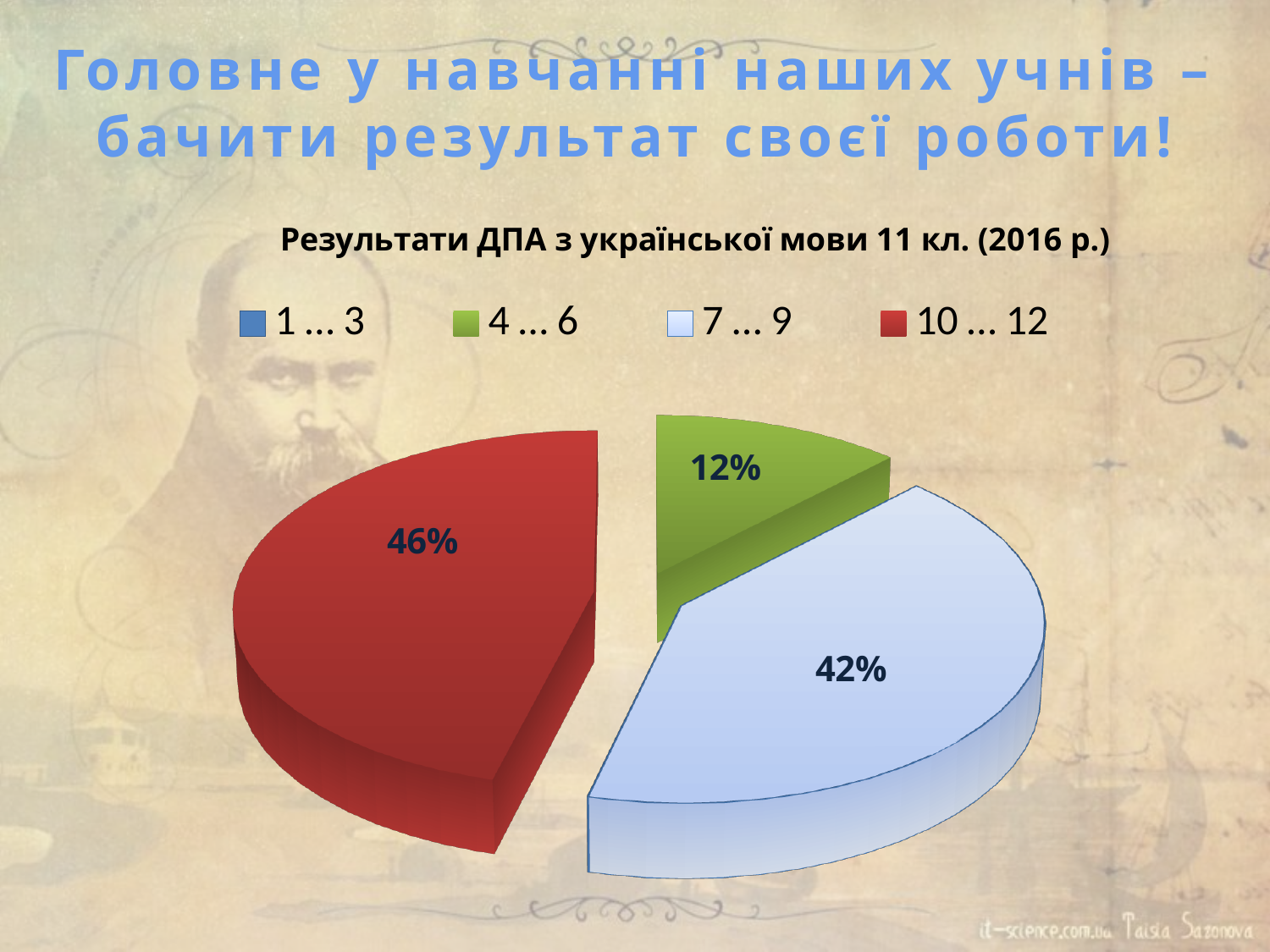
What percentage of the pie does the 4 … 6 category take? 12% What colour is the 10 … 12 slice? red What is the chart's title? Результати ДПА з української мови 11 кл. (2016 р.) What is the difference in percentage points between the 10 … 12 slice and the 7 … 9 slice? 4 Which slice is larger, 4 … 6 or 7 … 9? 7 … 9 Which of the labelled slices is the smallest? 4 … 6 What percentage of the pie does the 7 … 9 category take? 42% What kind of chart is shown on the slide? pie chart Which category has the largest slice of the pie? 10 … 12 What is the difference in percentage points between the 7 … 9 slice and the 4 … 6 slice? 30 How many categories does the legend list? 4 What percentage of the pie does the 10 … 12 category take? 46%